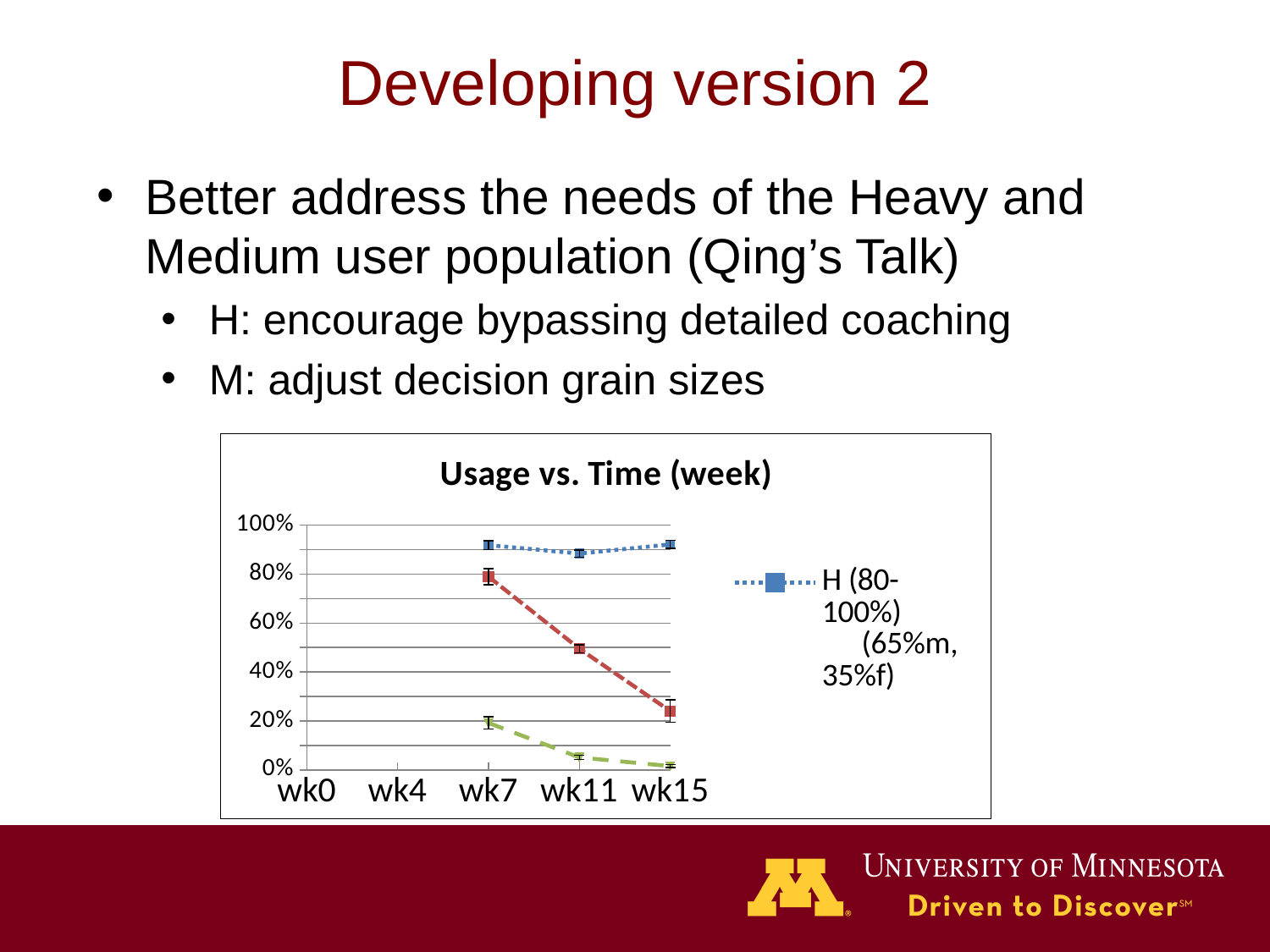
Does the green dashed series rise or fall from wk7 to wk15? fall Does the red dashed series rise or fall from wk7 to wk15? fall At wk15, which is larger: the H (80-100%) series or the red dashed series? H (80-100%) Is the value of the red dashed series at wk7 greater or less than 60%? greater How many lines are plotted in the chart? 3 What is the title of the chart? Usage vs. Time (week) Is the value of the red dashed series at wk15 greater or less than 40%? less Is the value of the H (80-100%) series at wk7 greater or less than 80%? greater Which series is named in the chart's legend? H (80-100%) (65%m, 35%f) How many week labels are shown on the x axis of the chart? 5 What kind of chart is shown on the slide? line chart